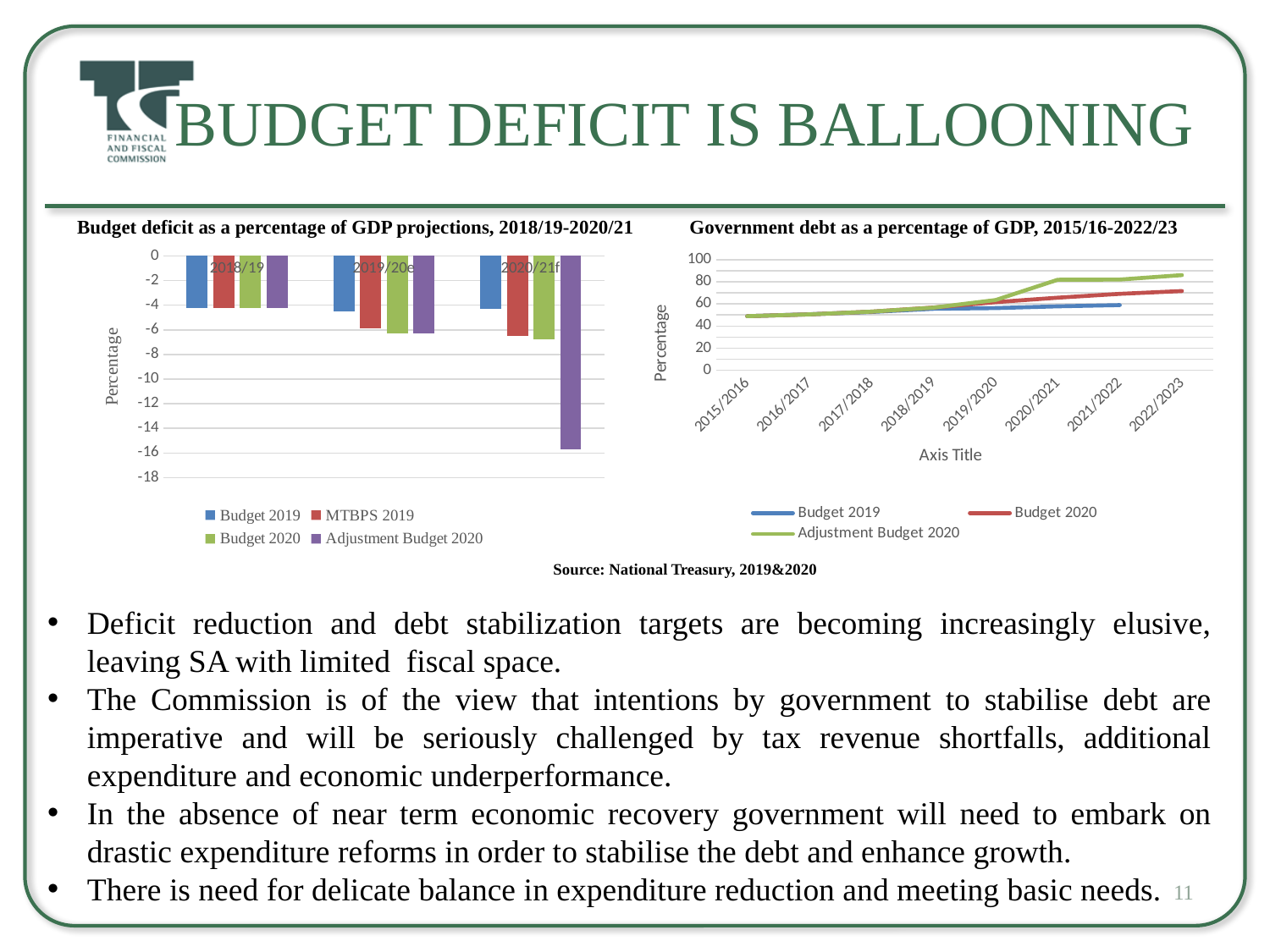
In the 'Budget deficit as a percentage of GDP projections' chart, which series has the lowest value for 2020/21f? Adjustment Budget 2020 How many categories are shown on the x axis of the 'Budget deficit as a percentage of GDP projections' chart? 3 In the 'Government debt as a percentage of GDP' chart, does the Adjustment Budget 2020 line rise or fall from 2015/2016 to 2022/2023? Rise In the 'Government debt as a percentage of GDP' chart, which is larger in 2021/2022: Budget 2020 or Budget 2019? Budget 2020 In the 'Budget deficit as a percentage of GDP projections' chart, is the Adjustment Budget 2020 value for 2020/21f greater or less than -14? less What kind of chart is the 'Budget deficit as a percentage of GDP projections, 2018/19-2020/21' chart? Bar chart What kind of chart is the 'Government debt as a percentage of GDP, 2015/16-2022/23' chart? Line chart In the 'Government debt as a percentage of GDP' chart, is the Adjustment Budget 2020 value for 2022/2023 greater or less than 80? greater How many series does the legend of the 'Budget deficit as a percentage of GDP projections' chart list? 4 In the 'Government debt as a percentage of GDP' chart, which series has the highest value in 2022/2023? Adjustment Budget 2020 How many series does the legend of the 'Government debt as a percentage of GDP' chart list? 3 How many fiscal years are shown on the x axis of the 'Government debt as a percentage of GDP' chart? 8